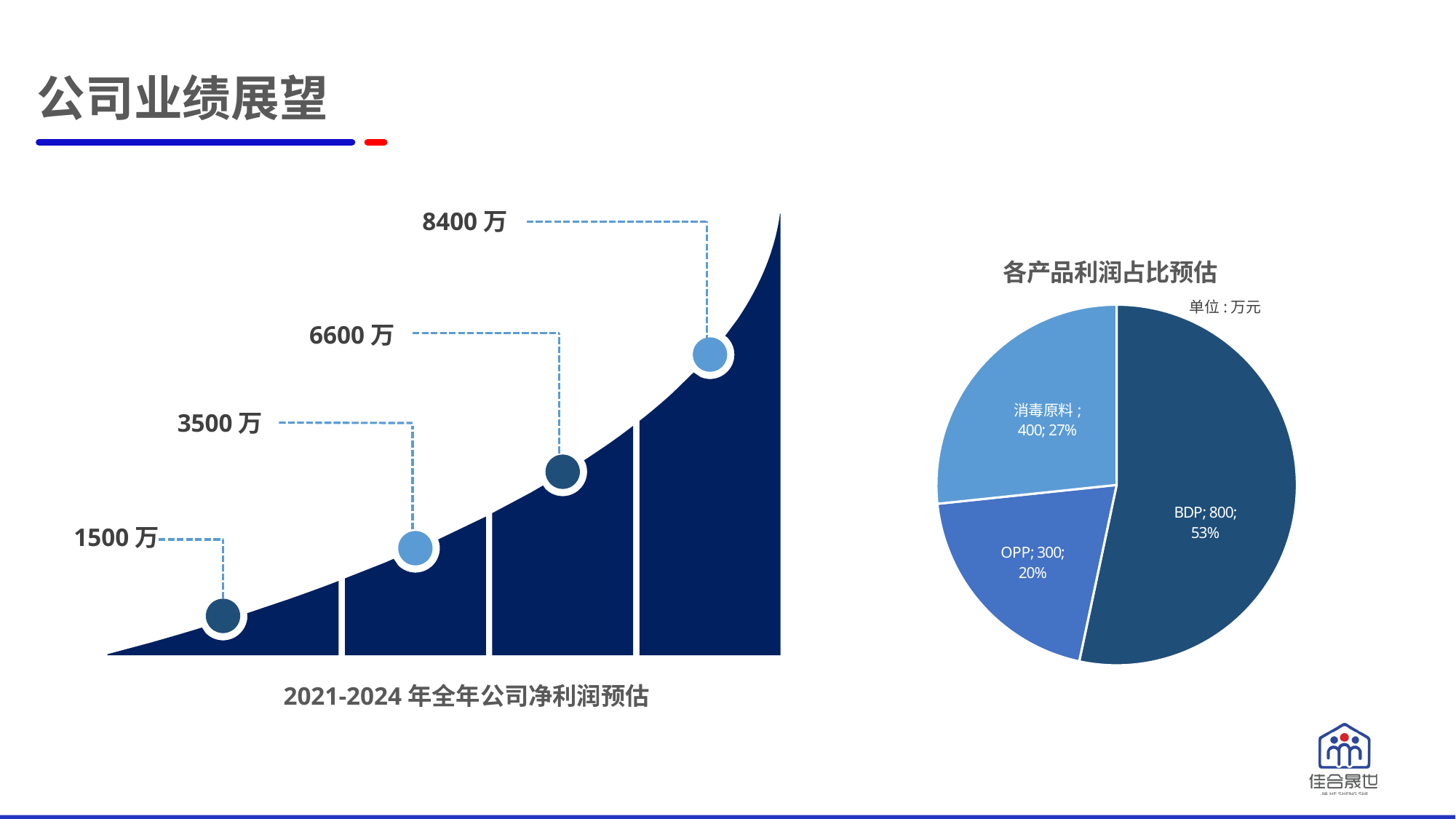
In the pie chart titled 各产品利润占比预估, what is the value for 消毒原料? 400 In the pie chart titled 各产品利润占比预估, what unit is stated for the values? 万元 In the pie chart titled 各产品利润占比预估, how many slices are there? 3 In the pie chart titled 各产品利润占比预估, what share of the pie does OPP take? 20% In the left chart titled 2021-2024 年全年公司净利润预估, how many data points are marked? 4 In the pie chart titled 各产品利润占比预估, what is the difference between the values for BDP and 消毒原料? 400 In the left chart titled 2021-2024 年全年公司净利润预估, what is the highest value shown? 8400 万 In the pie chart titled 各产品利润占比预估, which product has the largest slice? BDP In the pie chart titled 各产品利润占比预估, what is the value for BDP? 800 In the left chart titled 2021-2024 年全年公司净利润预估, what is the lowest value shown? 1500 万 In the left chart titled 2021-2024 年全年公司净利润预估, do the values rise or fall from left to right? rise In the pie chart titled 各产品利润占比预估, which product has the smallest slice? OPP